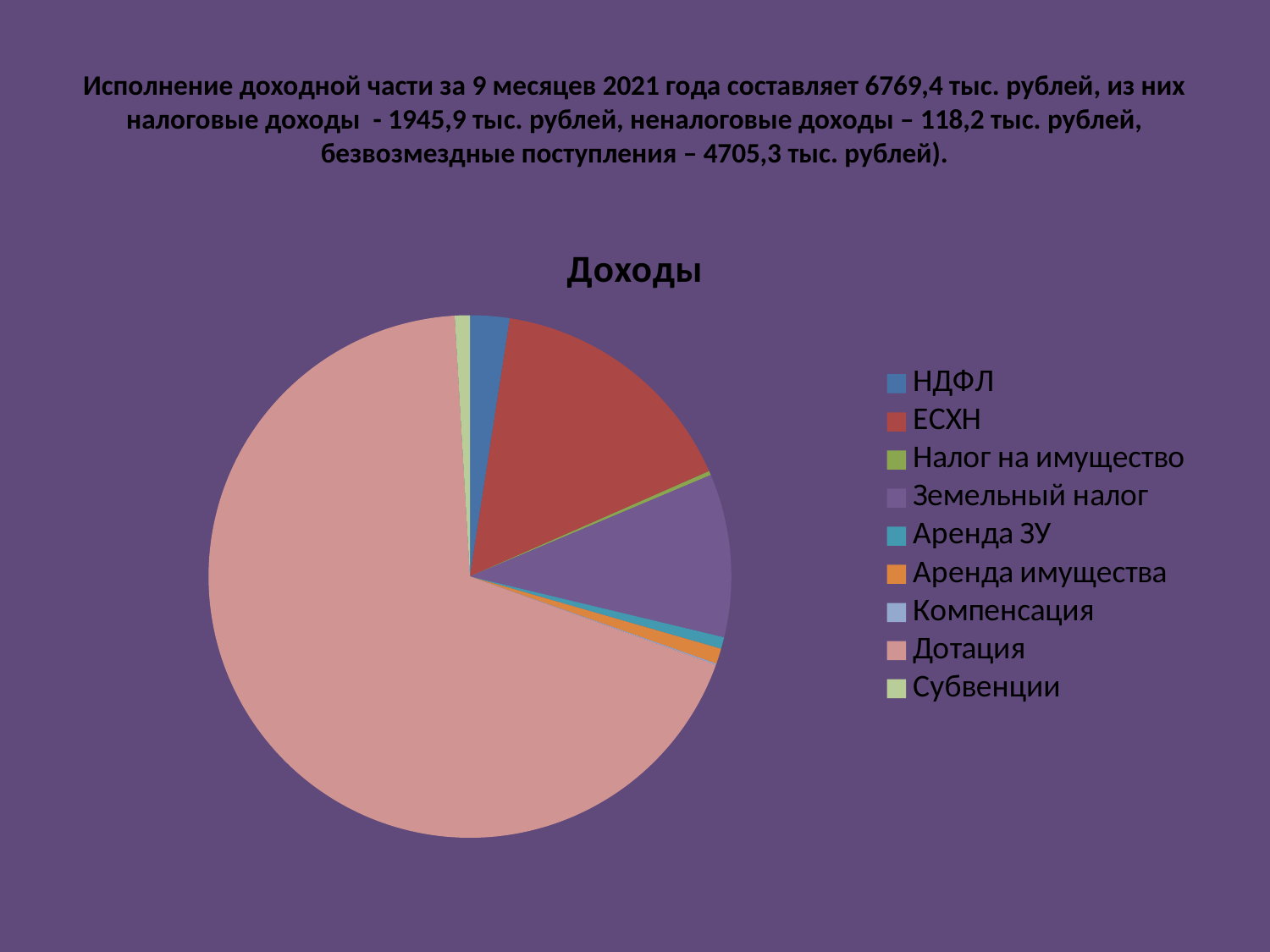
What kind of chart is shown on the slide? pie chart Does the Дотация slice take up more or less than half of the pie? more Which slice is larger, Земельный налог or Аренда ЗУ? Земельный налог Which slice is larger, ЕСХН or НДФЛ? ЕСХН Which category is the first entry in the legend? НДФЛ Which slice is larger, Земельный налог or Аренда имущества? Земельный налог How many categories does the legend of the pie chart list? 9 Which category has the largest slice of the pie chart? Дотация What is the title of the chart? Доходы